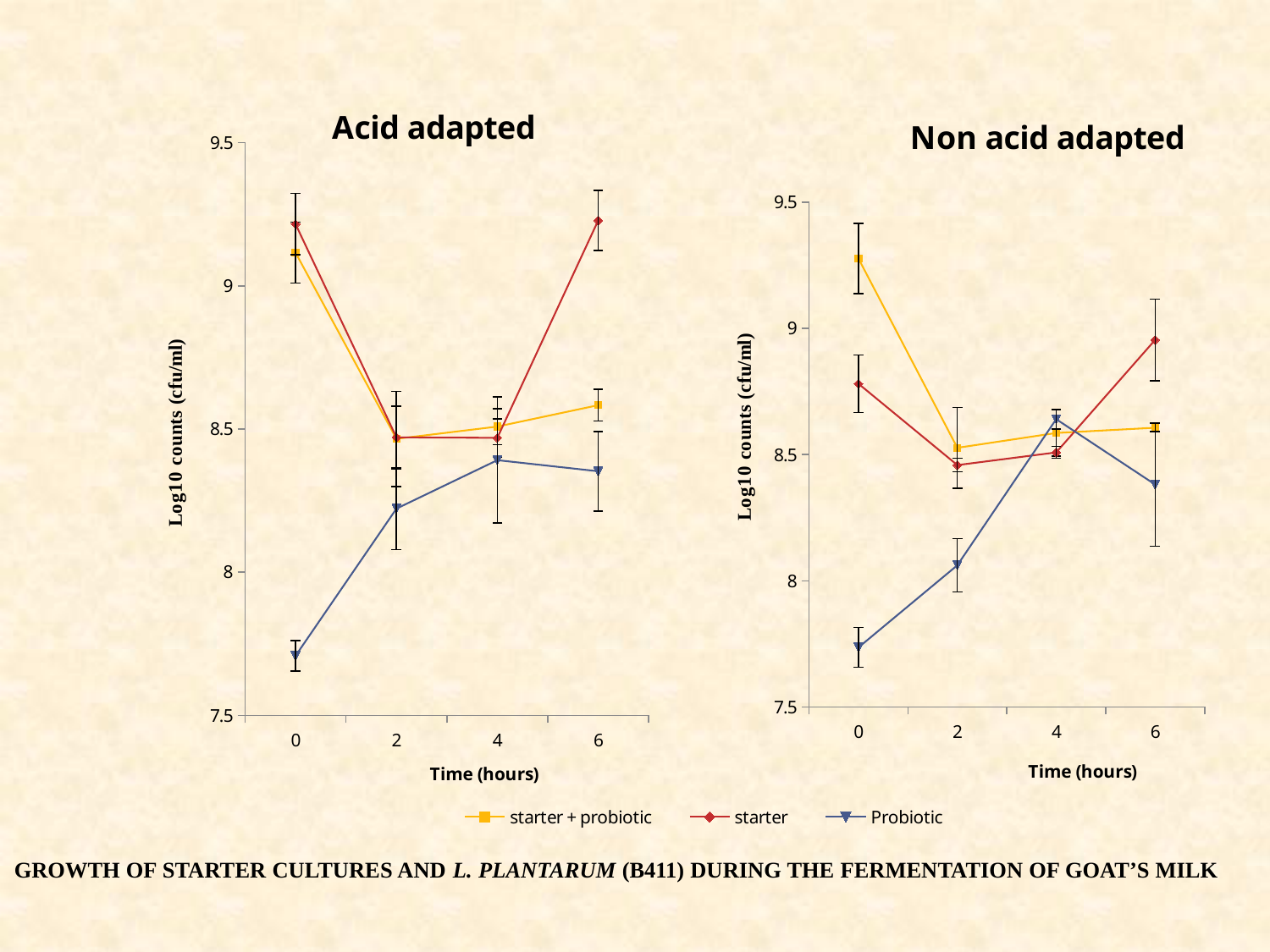
In the "Non acid adapted" chart, is the value for starter + probiotic at 0 hours greater or less than 9? greater In the "Acid adapted" chart, does the Probiotic series rise or fall from 0 to 4 hours? rise In the "Non acid adapted" chart, is the value for starter at 0 hours greater or less than 9? less What is the y-axis label of the "Acid adapted" chart? Log10 counts (cfu/ml) In the "Non acid adapted" chart, how many time points are plotted on the x axis? 4 In the "Acid adapted" chart, is the value for Probiotic at 0 hours greater or less than 8? less How many series does the legend list? 3 In the "Acid adapted" chart, which series has the lowest value at 0 hours? Probiotic In the "Non acid adapted" chart, which series has the highest value at 0 hours? starter + probiotic What kind of chart is the "Acid adapted" chart? line chart